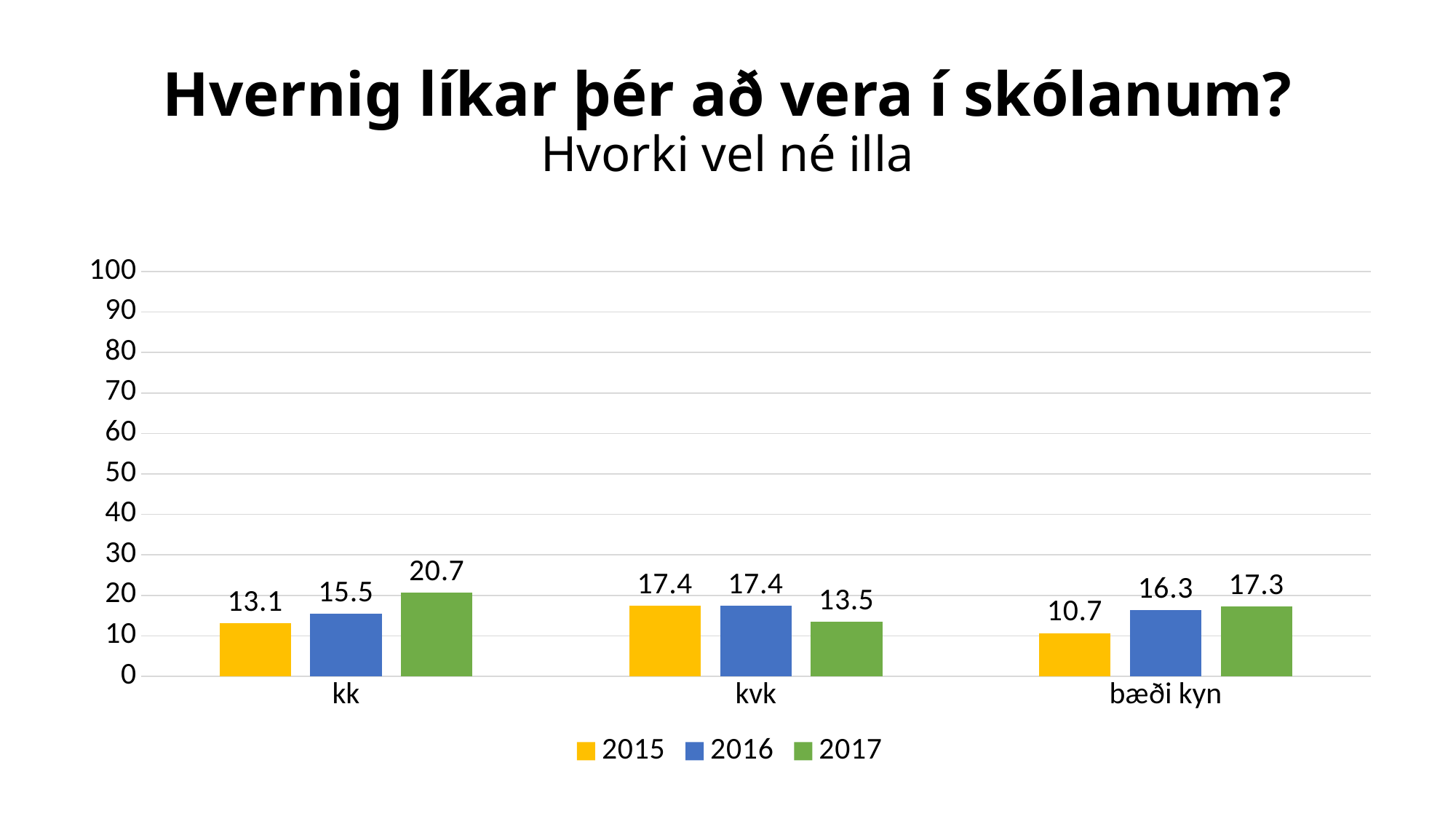
Which is larger: the 2017 value for kvk or the 2017 value for bæði kyn? bæði kyn Which category has the lowest value in the 2015 series? bæði kyn What is the value for bæði kyn in 2015? 10.7 Which category has the highest value in the 2017 series? kk What is the subtitle shown below the chart title? Hvorki vel né illa Is the value for kk in 2017 greater or less than 30? less What is the value for kvk in 2016? 17.4 What is the value for kk in 2017? 20.7 What is the difference between the 2017 and 2015 values for kk? 7.6 How many categories are shown on the x axis? 3 How many series does the legend list? 3 What kind of chart is shown on the slide? bar chart